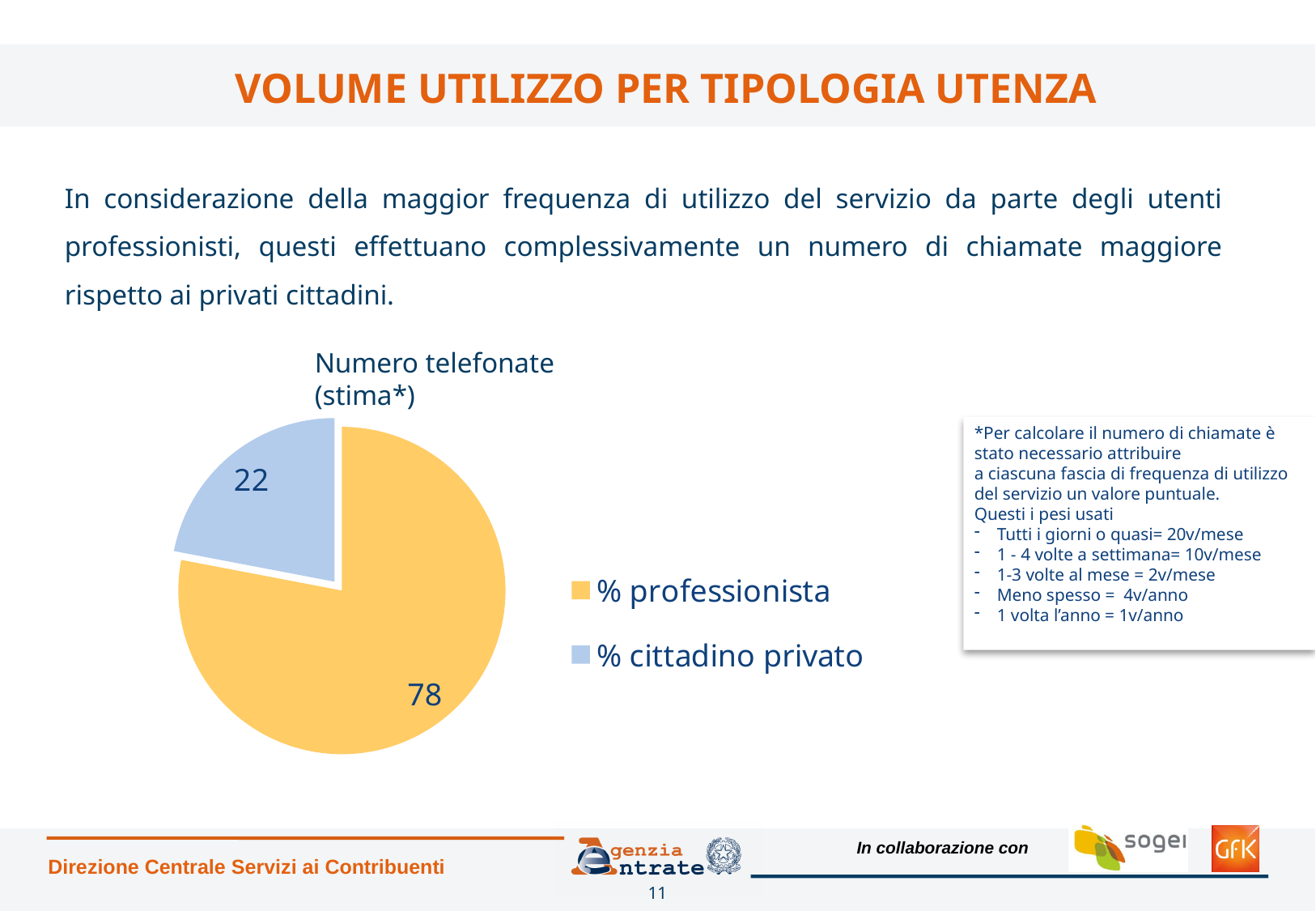
What is the difference between the values for % professionista and % cittadino privato? 56 What is the value for % professionista in the pie chart? 78 What is the value for % cittadino privato in the pie chart? 22 Which category has the smallest slice in the pie chart? % cittadino privato What is the title of the pie chart? Numero telefonate (stima*) How many entries does the legend list? 2 Which category has the largest slice in the pie chart? % professionista Which is larger, the slice for % professionista or the slice for % cittadino privato? % professionista What is the total of the two values shown in the pie chart? 100 How many slices does the pie chart have? 2 What colour is the slice for % cittadino privato? light blue What kind of chart is shown on the slide? pie chart